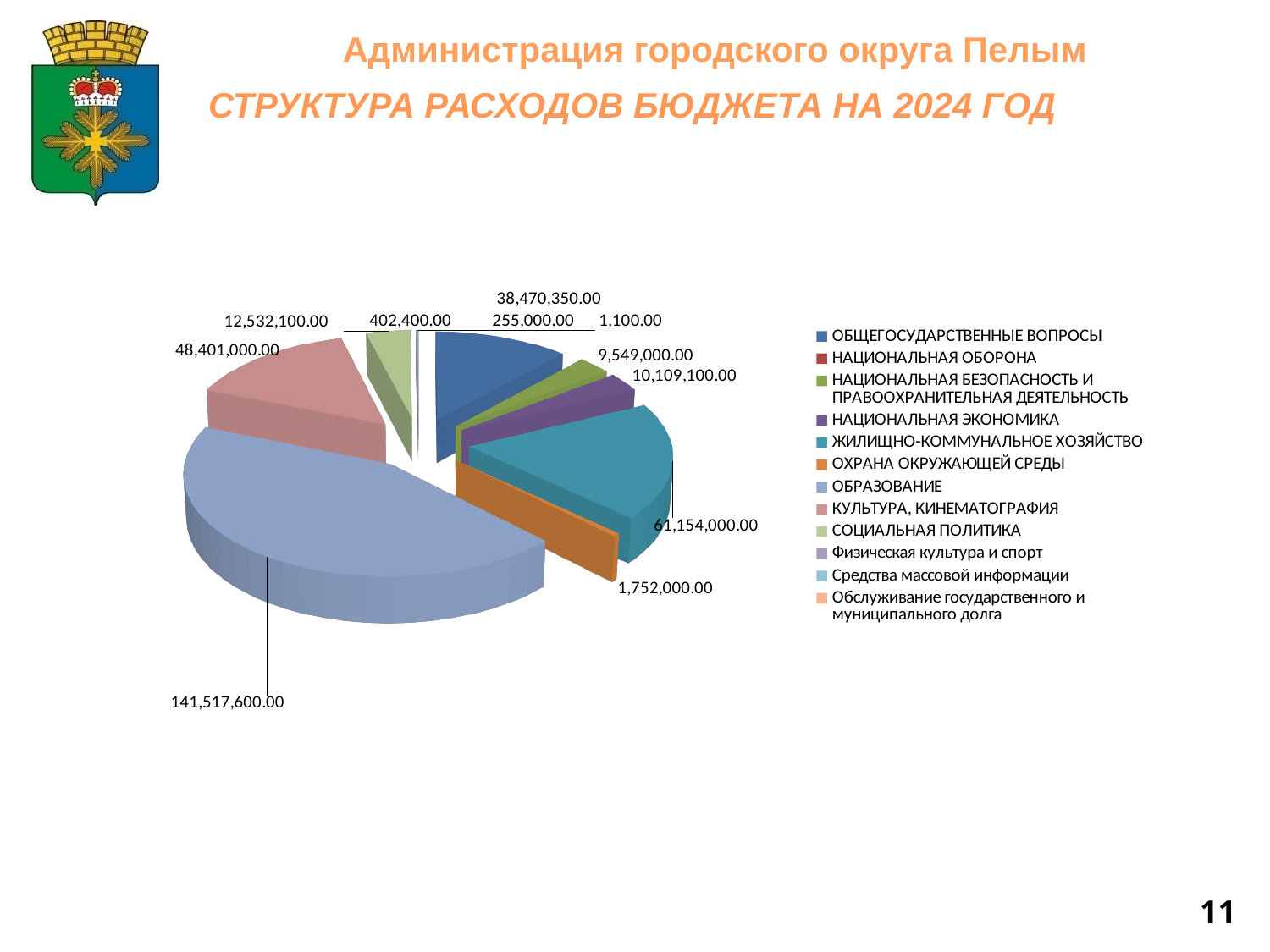
What is the title of the chart on the slide? СТРУКТУРА РАСХОДОВ БЮДЖЕТА НА 2024 ГОД What is the difference between the value for ОБРАЗОВАНИЕ and the value for ЖИЛИЩНО-КОММУНАЛЬНОЕ ХОЗЯЙСТВО? 80,363,600.00 Which category has the largest slice in the pie chart? ОБРАЗОВАНИЕ What is the value shown for ОБРАЗОВАНИЕ? 141,517,600.00 What is the value shown for СОЦИАЛЬНАЯ ПОЛИТИКА? 12,532,100.00 What is the value shown for ЖИЛИЩНО-КОММУНАЛЬНОЕ ХОЗЯЙСТВО? 61,154,000.00 What is the value shown for ОБЩЕГОСУДАРСТВЕННЫЕ ВОПРОСЫ? 38,470,350.00 Which is larger, the value for ЖИЛИЩНО-КОММУНАЛЬНОЕ ХОЗЯЙСТВО or the value for КУЛЬТУРА, КИНЕМАТОГРАФИЯ? ЖИЛИЩНО-КОММУНАЛЬНОЕ ХОЗЯЙСТВО What kind of chart is shown on the slide? Pie chart What is the value shown for КУЛЬТУРА, КИНЕМАТОГРАФИЯ? 48,401,000.00 How many categories does the legend of the pie chart list? 12 What is the value shown for НАЦИОНАЛЬНАЯ ЭКОНОМИКА? 10,109,100.00